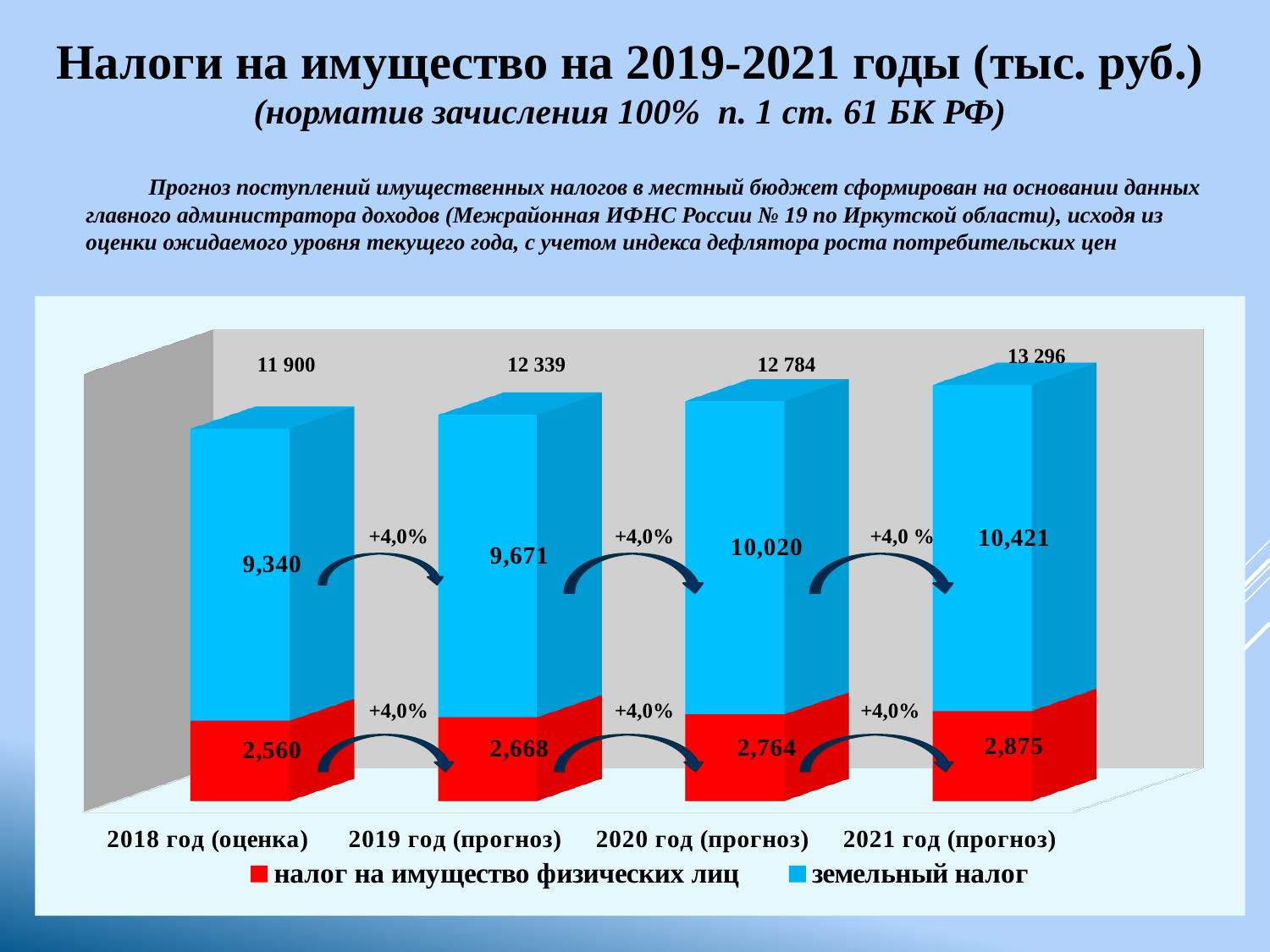
Which year has the highest value of земельный налог? 2021 год (прогноз) What kind of chart is shown on the slide? stacked bar chart What is the difference between земельный налог in 2021 год (прогноз) and 2020 год (прогноз)? 401 Which year has the lowest value of налог на имущество физических лиц? 2018 год (оценка) What is the value of земельный налог for 2020 год (прогноз)? 10,020 Which is larger: налог на имущество физических лиц in 2019 год (прогноз) or земельный налог in 2019 год (прогноз)? земельный налог What is the value of налог на имущество физических лиц for 2021 год (прогноз)? 2,875 How many series does the legend list? 2 What is the value of земельный налог for 2018 год (оценка)? 9,340 What is the total shown above the bar for 2021 год (прогноз)? 13 296 How many year categories are shown on the x axis? 4 What is the total shown above the bar for 2019 год (прогноз)? 12 339